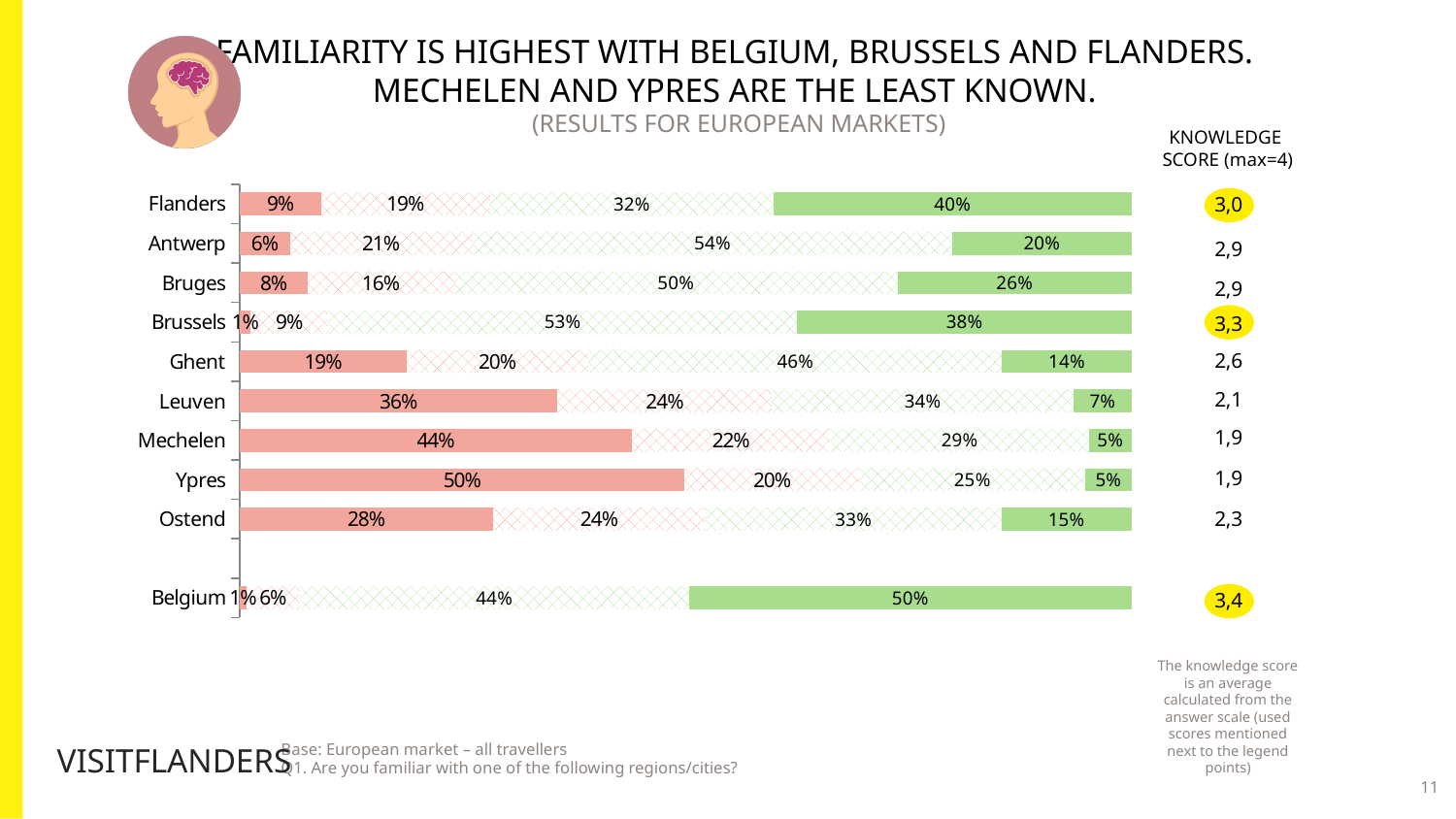
How many categories (regions/cities) are shown in the chart? 10 Which has a larger solid green (rightmost) segment, Antwerp or Bruges? Bruges What is the value of the solid green (rightmost) segment for Belgium? 50% What is the value of the solid red (leftmost) segment for Ypres? 50% Which category has the largest solid green (rightmost) segment? Belgium What is the knowledge score for Brussels? 3,3 What kind of chart is shown on the slide? Stacked bar chart What is the value of the red hatched (second) segment for Antwerp? 21% Which category has the largest solid red (leftmost) segment? Ypres What is the total of the four segments in the Flanders bar? 100% Which category has the highest knowledge score? Belgium What is the difference between the solid green segment for Flanders and the solid green segment for Ghent? 26 percentage points